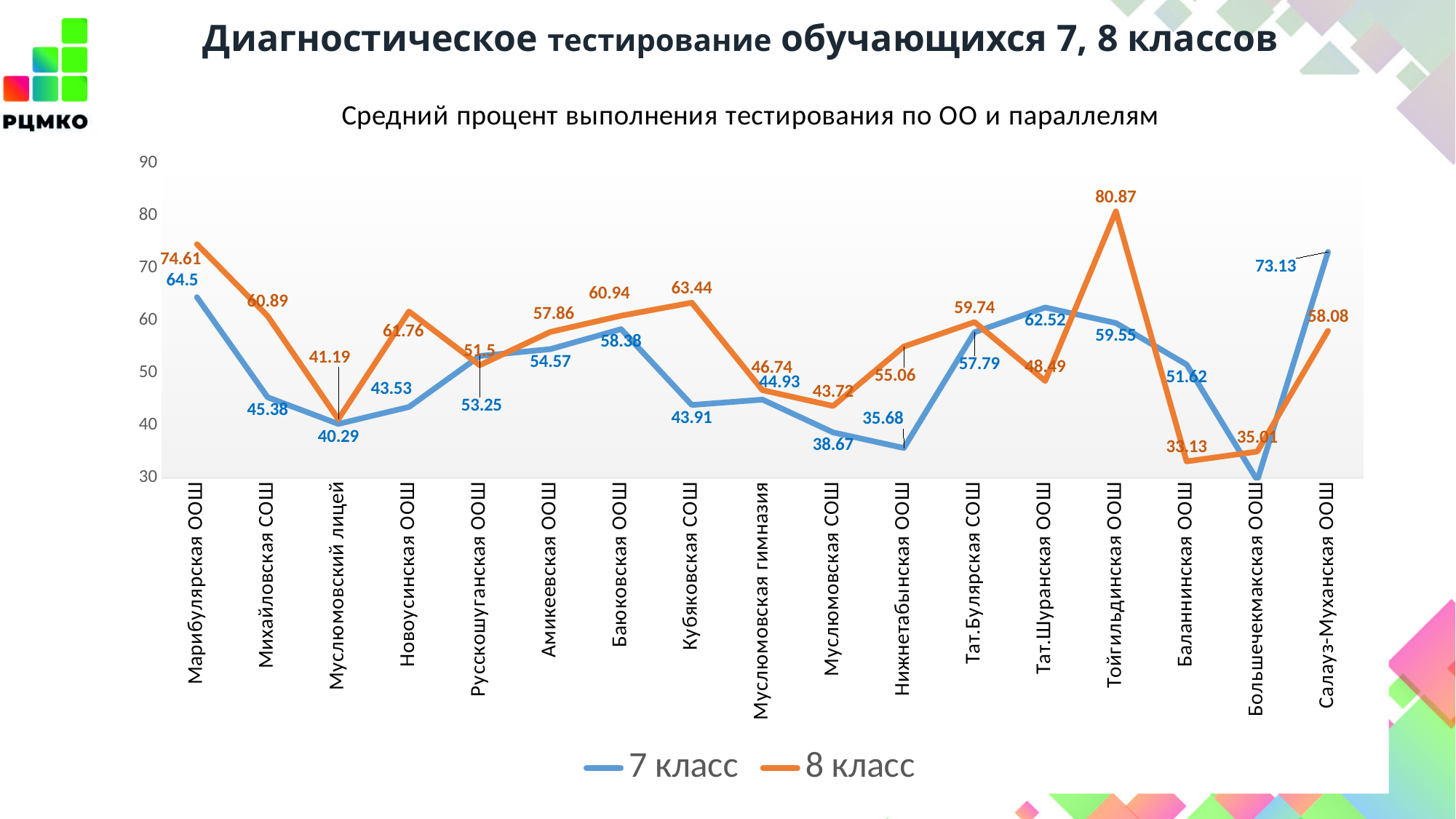
How many series does the legend list? 2 What is the value for 7 класс at Салауз-Муханская ООШ? 73.13 What is the value for 7 класс at Нижнетабынская ООШ? 35.68 How many schools are shown on the x axis? 17 Which school has the highest value for 7 класс? Салауз-Муханская ООШ What is the value for 8 класс at Тойгильдинская ООШ? 80.87 Which school has the lowest value for 8 класс? Баланнинская ООШ What kind of chart is shown on the slide? line chart Is the value for 7 класс at Большечекмакская ООШ greater or less than 40? less What is the difference between the 8 класс and 7 класс values at Тойгильдинская ООШ? 21.32 At Тат.Шуранская ООШ, which is larger: the 7 класс value or the 8 класс value? 7 класс Which school has the highest value for 8 класс? Тойгильдинская ООШ